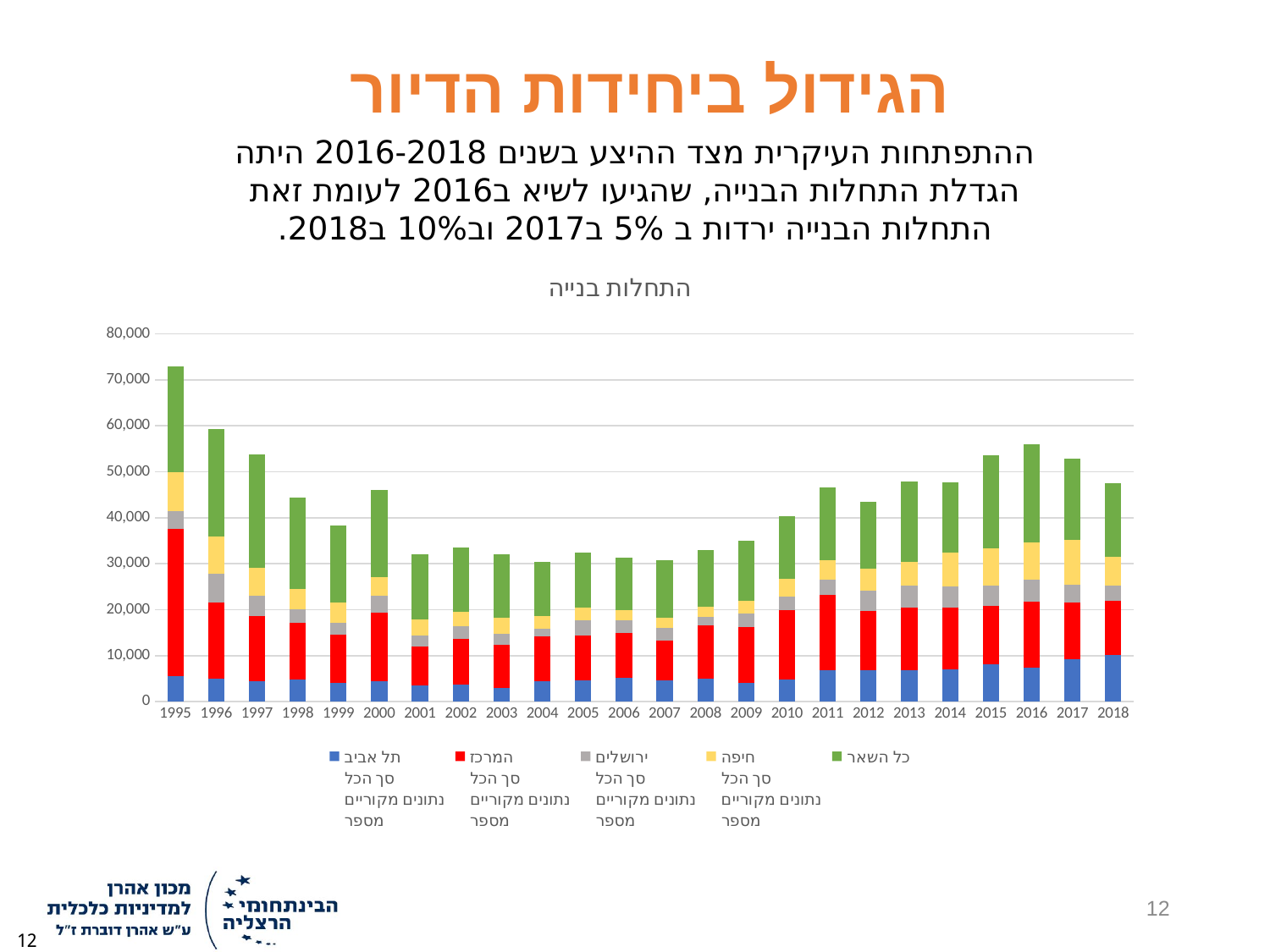
Is the total value for 2004 greater or less than 40,000? less What kind of chart is shown on the slide? stacked bar chart Which year has the highest total construction starts in the chart? 1995 How many series does the chart's legend list? 5 What is the title of the chart? התחלות בנייה How many years are shown along the x axis of the chart? 24 Is the total value for 1995 greater or less than 70,000? greater Which year has the larger total, 1995 or 2016? 1995 Which series is shown in green in the chart? כל השאר Is the total value for 2010 greater or less than 50,000? less Do the total values rise or fall from 1995 to 1999? fall